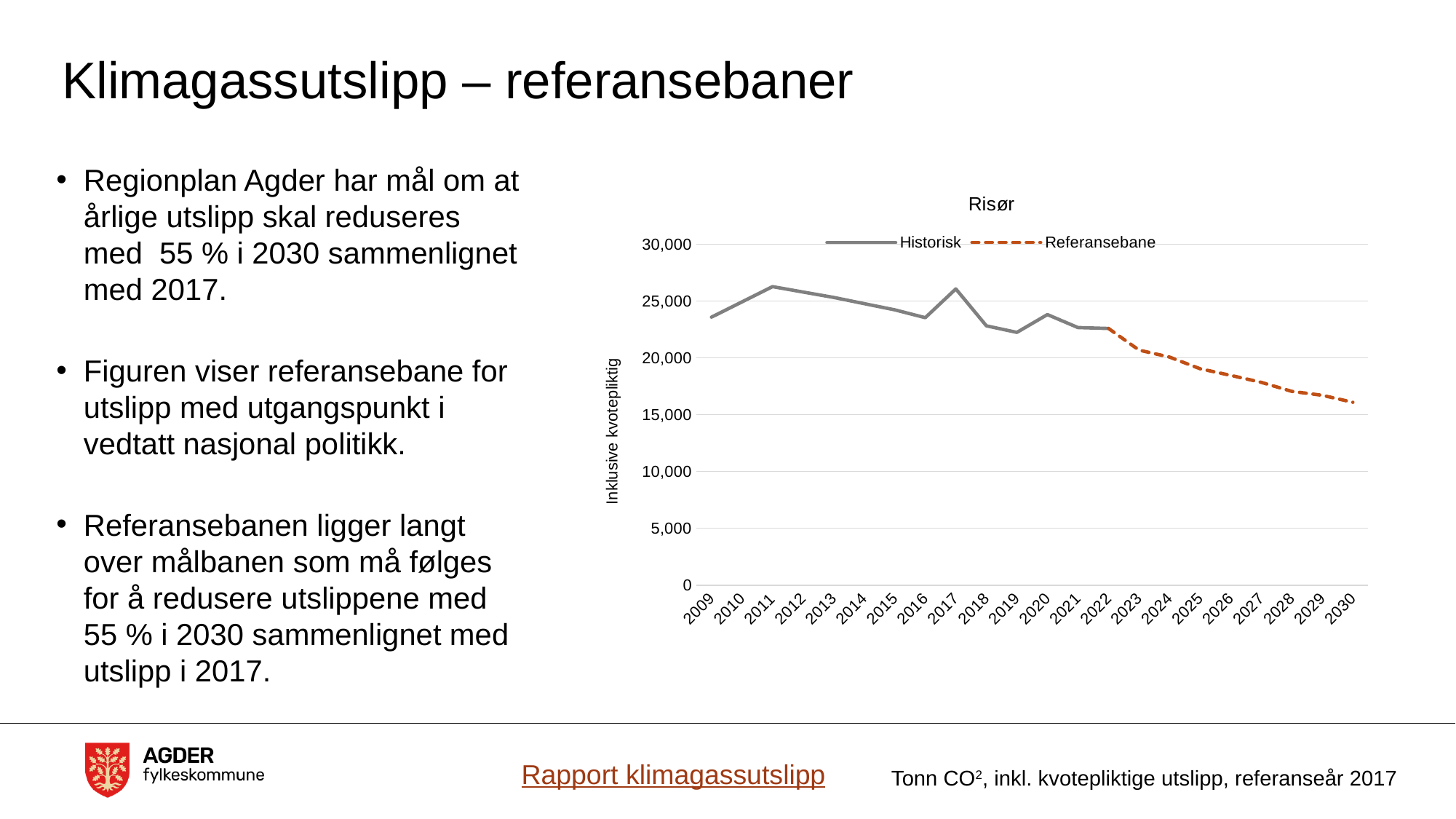
Which year has the lowest value on the chart? 2030 Is the value for 2009 greater or less than 25,000? less Does the Referansebane series rise or fall from 2023 to 2030? fall Is the value for 2030 greater or less than 15,000? greater What kind of chart is shown on the slide? line chart What is the title of the chart? Risør Is the value for 2025 greater or less than 20,000? less How many years are shown on the x axis of the chart? 22 Which series is drawn with a dashed line? Referansebane How many series does the chart legend list? 2